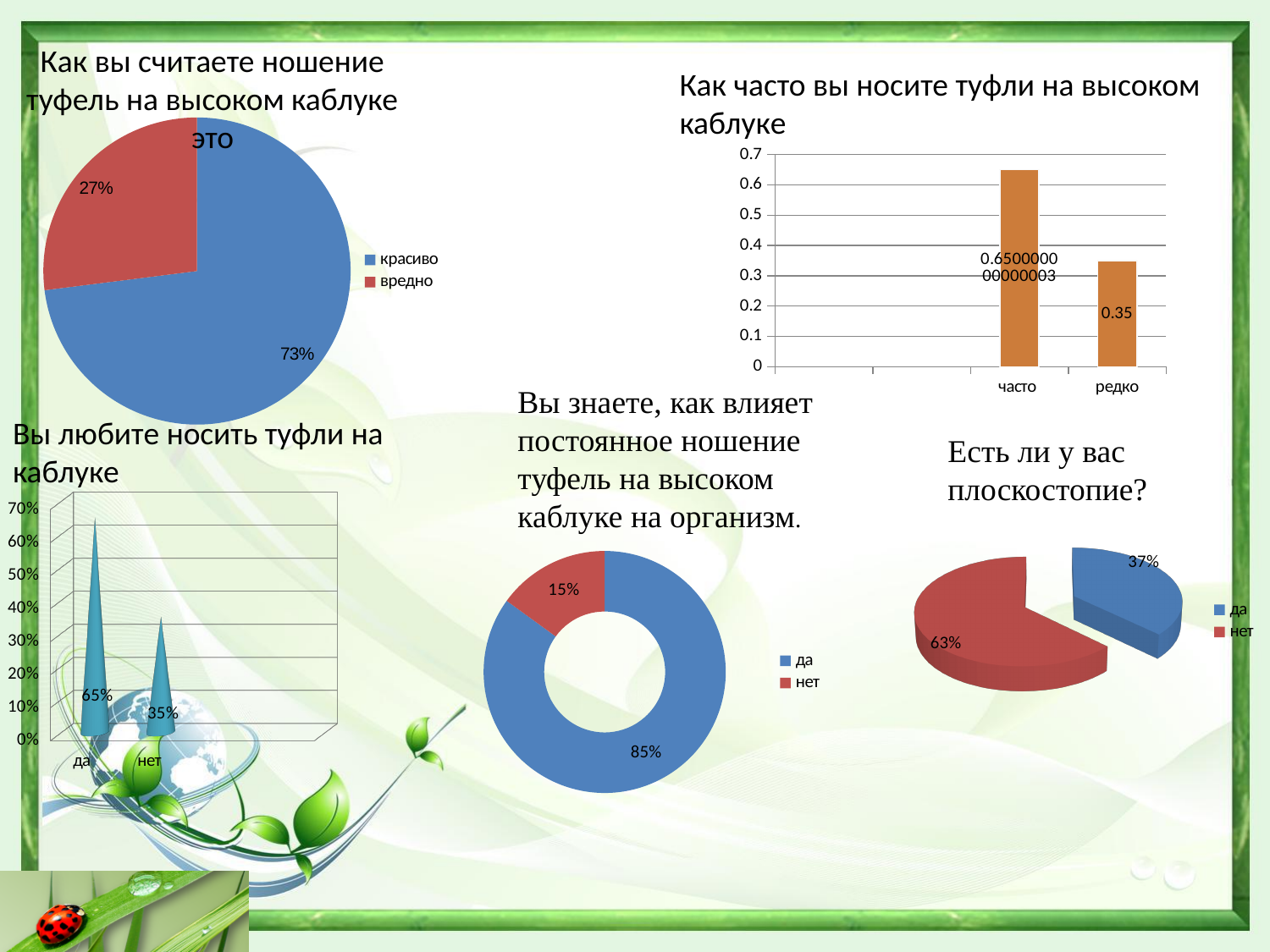
In the bar chart titled 'Как часто вы носите туфли на высоком каблуке', what value is labelled for 'редко'? 0.35 How many entries does the legend of the pie chart titled 'Есть ли у вас плоскостопие?' list? 2 In the pie chart titled 'Как вы считаете ношение туфель на высоком каблуке это', what percentage is shown for 'красиво'? 73% In the chart titled 'Вы любите носить туфли на каблуке', what percentage is shown for 'да'? 65% What kind of chart is the chart titled 'Как часто вы носите туфли на высоком каблуке'? bar chart In the chart titled 'Вы любите носить туфли на каблуке', what is the difference between the values for 'да' and 'нет'? 30% In the pie chart titled 'Есть ли у вас плоскостопие?', what percentage is shown for 'нет'? 63% In the bar chart titled 'Как часто вы носите туфли на высоком каблуке', which category has the highest bar? часто In the pie chart titled 'Как вы считаете ношение туфель на высоком каблуке это', which slice is larger, 'красиво' or 'вредно'? красиво In the pie chart titled 'Как вы считаете ношение туфель на высоком каблуке это', what percentage is shown for 'вредно'? 27% In the bar chart titled 'Как часто вы носите туфли на высоком каблуке', is the value for 'часто' greater or less than 0.6? greater In the doughnut chart titled 'Вы знаете, как влияет постоянное ношение туфель на высоком каблуке на организм', what percentage is shown for 'нет'? 15%